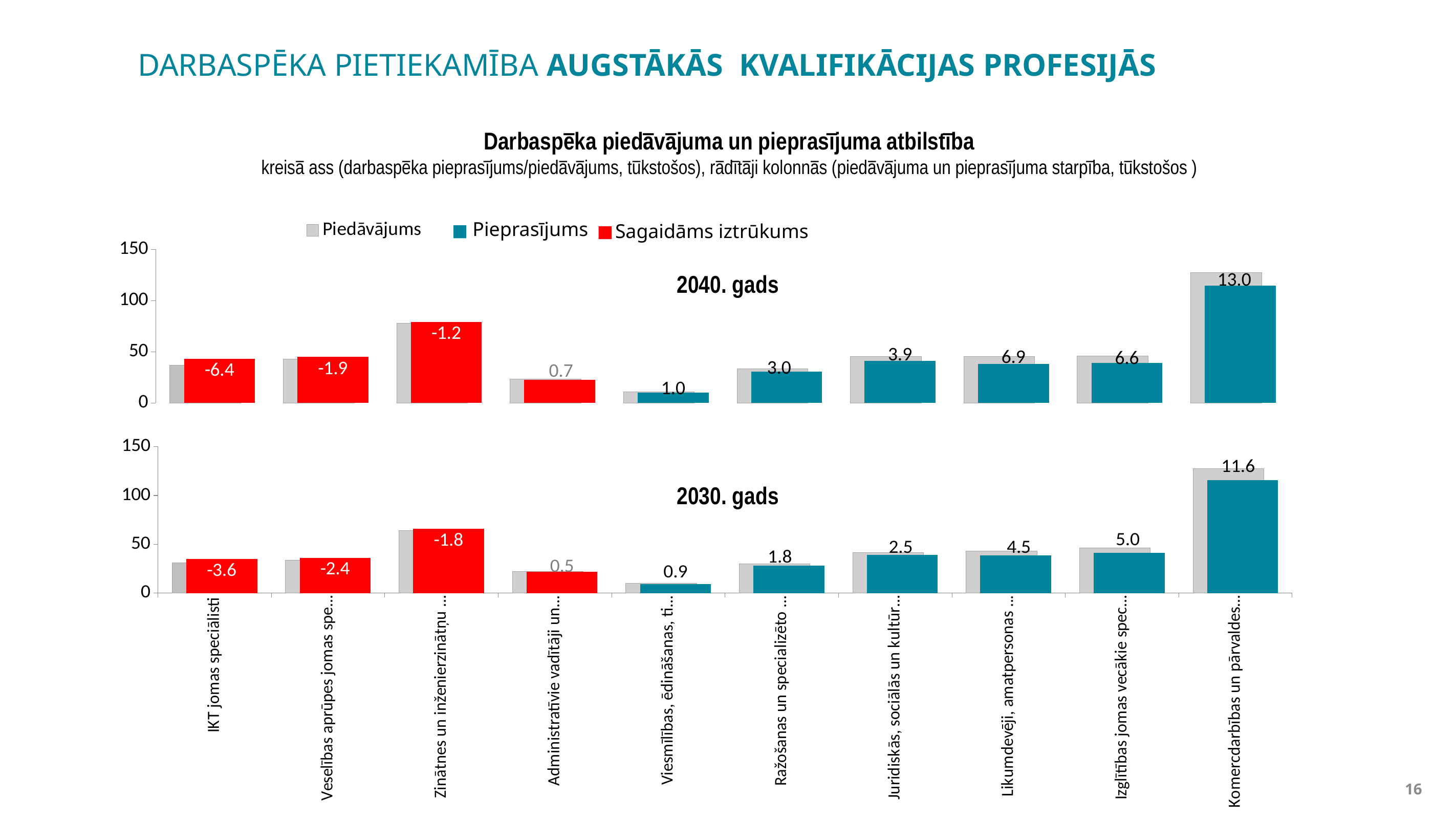
How many categories are shown along the x axis of the 2030. gads chart? 10 In the 2040. gads chart, which category has the lowest data label? IKT jomas speciālisti What kind of chart is the 2040. gads chart? bar chart Which series is shown in red in the legend? Sagaidāms iztrūkums What is the difference between the data label for Komercdarbības un pārvaldes... in the 2040. gads chart (13.0) and in the 2030. gads chart (11.6)? 1.4 In the 2040. gads chart, which category has the highest data label? Komercdarbības un pārvaldes... In the 2040. gads chart, is the Pieprasījums bar for Komercdarbības un pārvaldes... greater or less than 100? greater In the 2030. gads chart, what is the data label for Komercdarbības un pārvaldes...? 11.6 In the 2030. gads chart, which data label is larger: Likumdevēji, amatpersonas... or Izglītības jomas vecākie spec...? Izglītības jomas vecākie spec... How many series does the legend list? 3 In the 2030. gads chart, what is the data label shown for IKT jomas speciālisti? -3.6 In the 2040. gads chart, what is the data label shown for IKT jomas speciālisti? -6.4